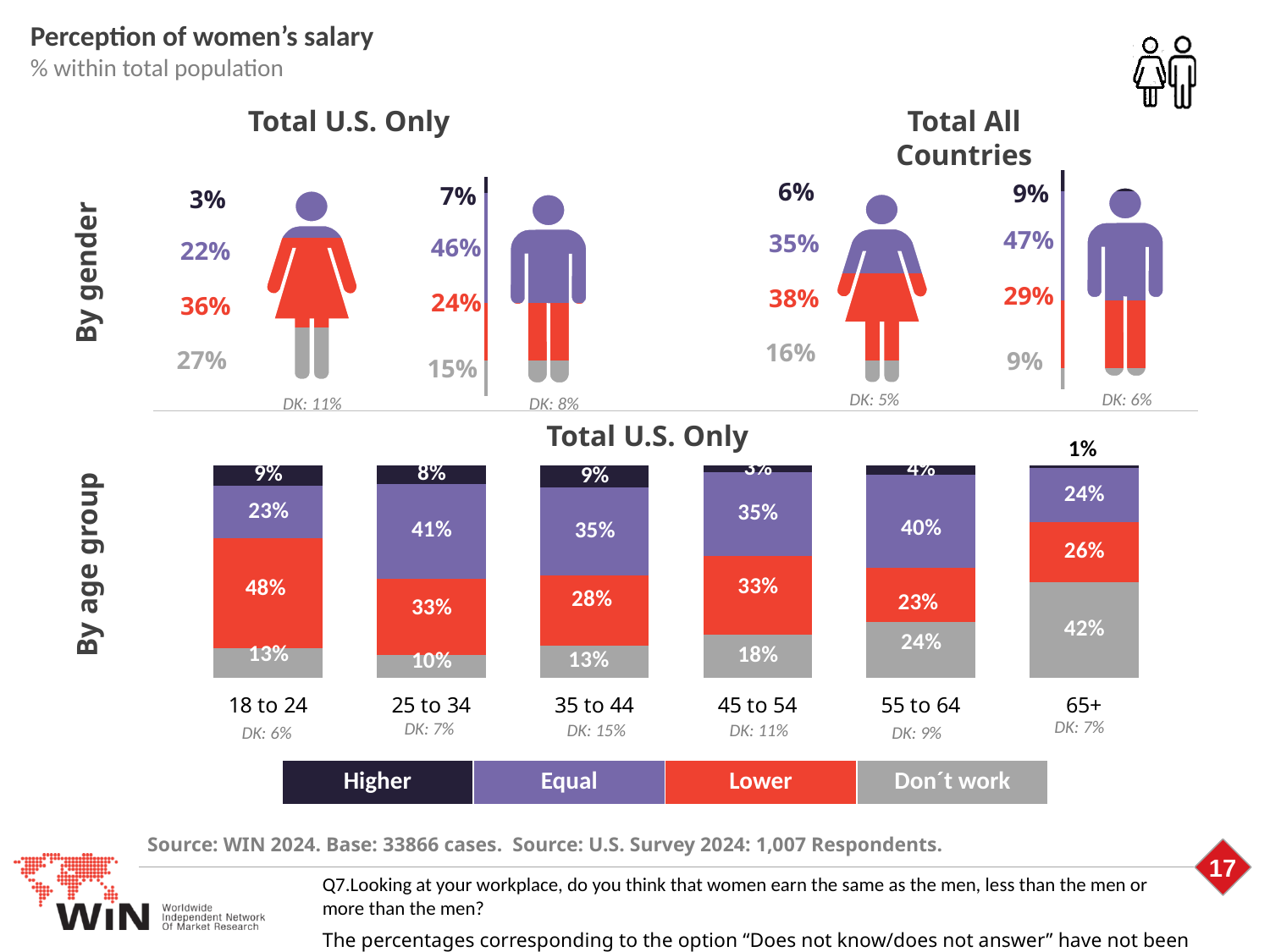
How many age groups are shown in the By age group chart? 6 In the By age group chart, which has the larger Equal share: 25 to 34 or 35 to 44? 25 to 34 What colour represents the Lower response in the legend? Red What kind of chart is the By age group chart? Stacked bar chart In the By gender chart for Total All Countries, what percentage of men answered Equal? 47% In the By age group chart, what is the difference between the Lower share for 18 to 24 and the Lower share for 65+? 22 percentage points In the By age group chart, which age group has the highest Don't work share? 65+ In the By age group chart, what percentage of the 18 to 24 group answered Lower? 48% In the By age group chart, which age group has the lowest Don't work share? 25 to 34 How many response categories does the legend list? 4 In the By gender chart for Total U.S. Only, what is the difference between the Equal share for men and the Equal share for women? 24 percentage points In the By gender chart for Total U.S. Only, what percentage of women answered Lower? 36%